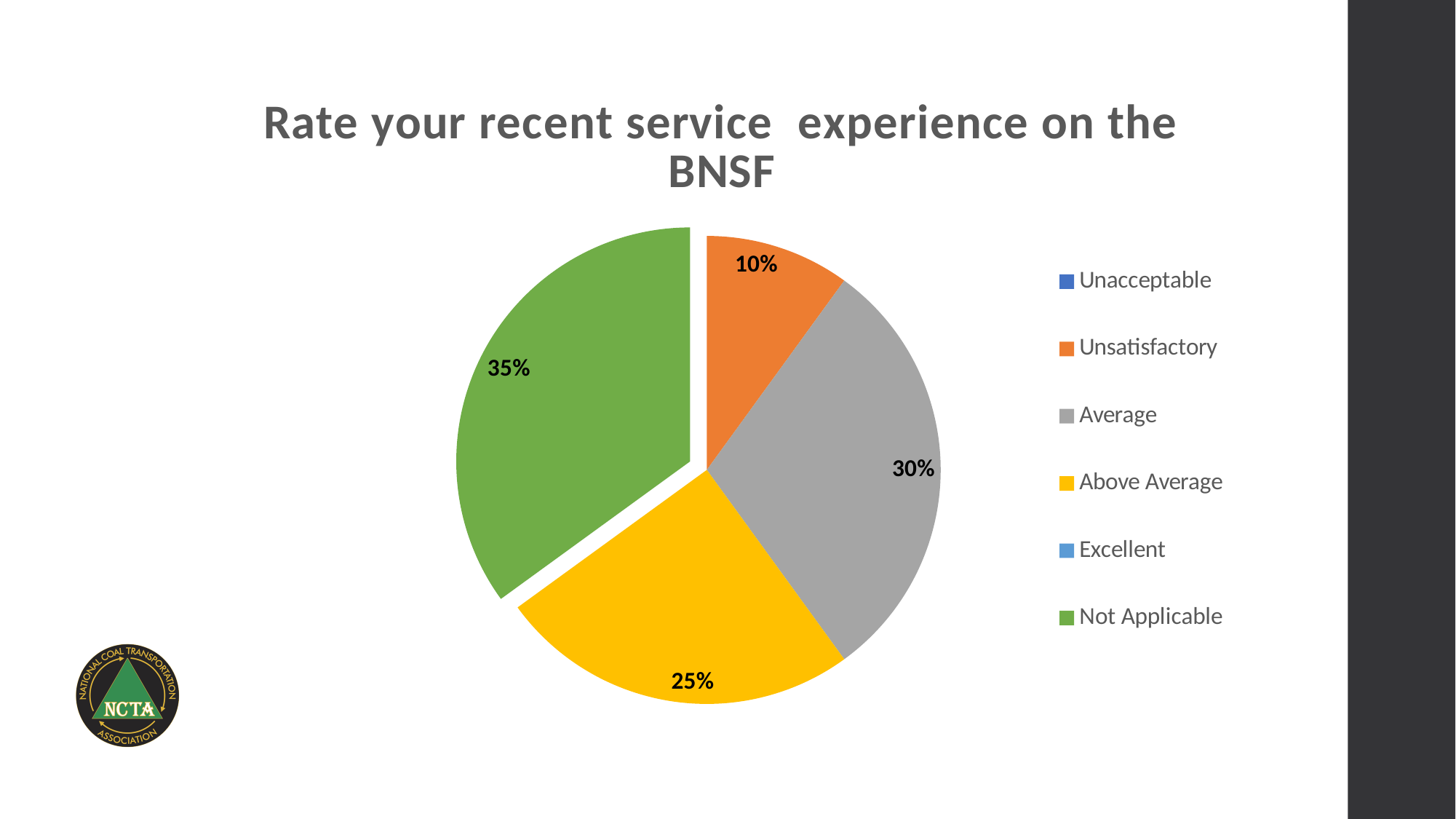
What percentage is shown for the Above Average slice? 25% What share of the pie is labelled for Not Applicable? 35% Which category with a visible slice has the smallest share? Unsatisfactory What percentage is shown for the Average slice? 30% What percentage is shown for the Unsatisfactory slice? 10% Which category has the largest slice of the pie? Not Applicable What is the title of the chart? Rate your recent service experience on the BNSF How many categories does the legend list? 6 What kind of chart is shown on the slide? Pie chart What is the difference in percentage points between the Not Applicable and Unsatisfactory slices? 25 Which slice is larger, Average or Above Average? Average What colour is the Above Average slice? Yellow